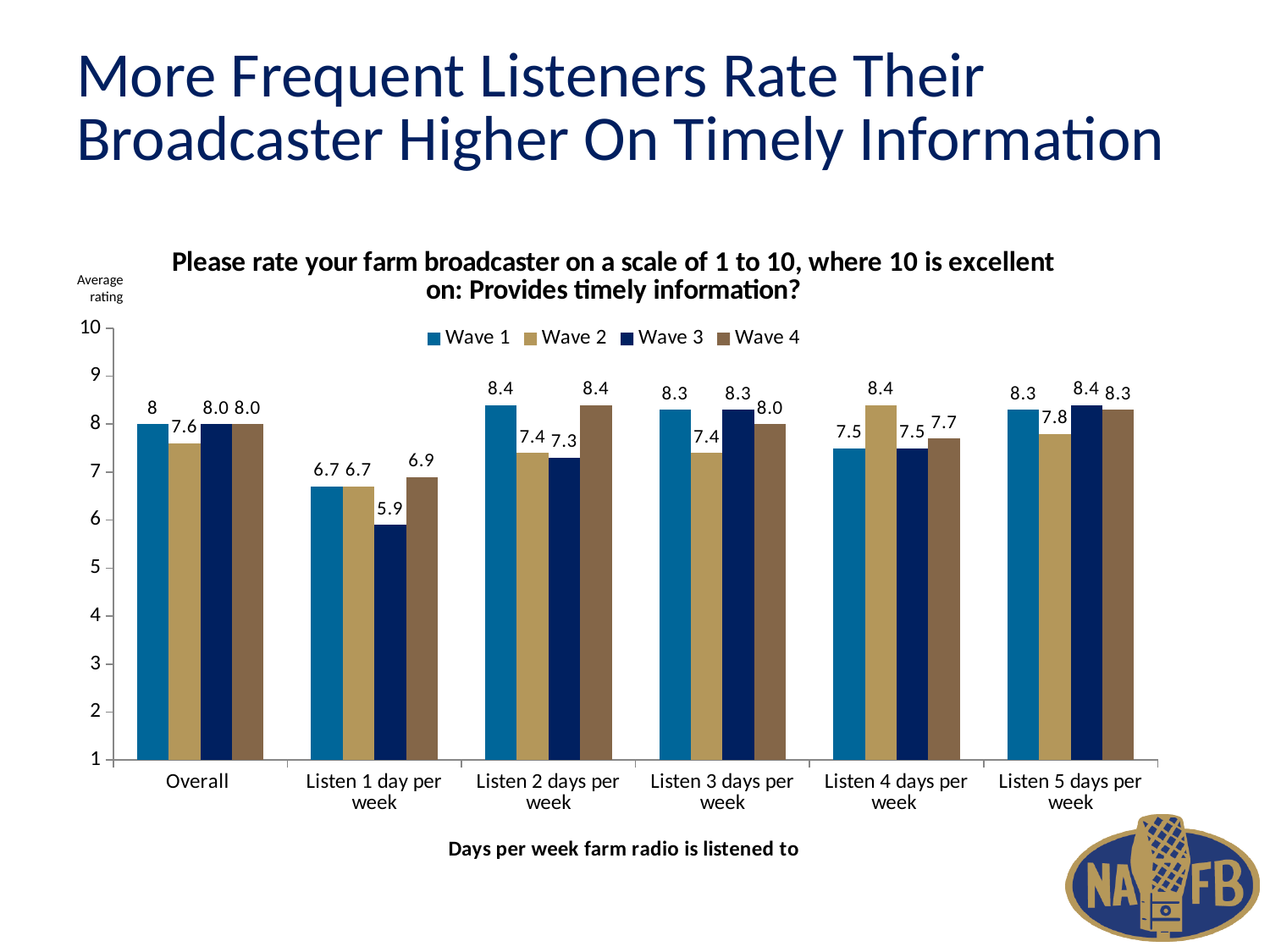
What is the Wave 4 value for Listen 3 days per week? 8.0 What is the Wave 3 value for Listen 1 day per week? 5.9 What is the Wave 1 value for Overall? 8 What kind of chart is shown on the slide? Bar chart Which category has the lowest Wave 3 value? Listen 1 day per week What is the Wave 2 value for Listen 4 days per week? 8.4 How many categories are shown on the x axis? 6 What is the difference between the Wave 4 and Wave 3 values for Listen 1 day per week? 1.0 How many series does the legend list? 4 What is the x-axis title of the chart? Days per week farm radio is listened to Which category has the highest Wave 2 value? Listen 4 days per week Which is larger for Listen 2 days per week, the Wave 1 value or the Wave 2 value? Wave 1